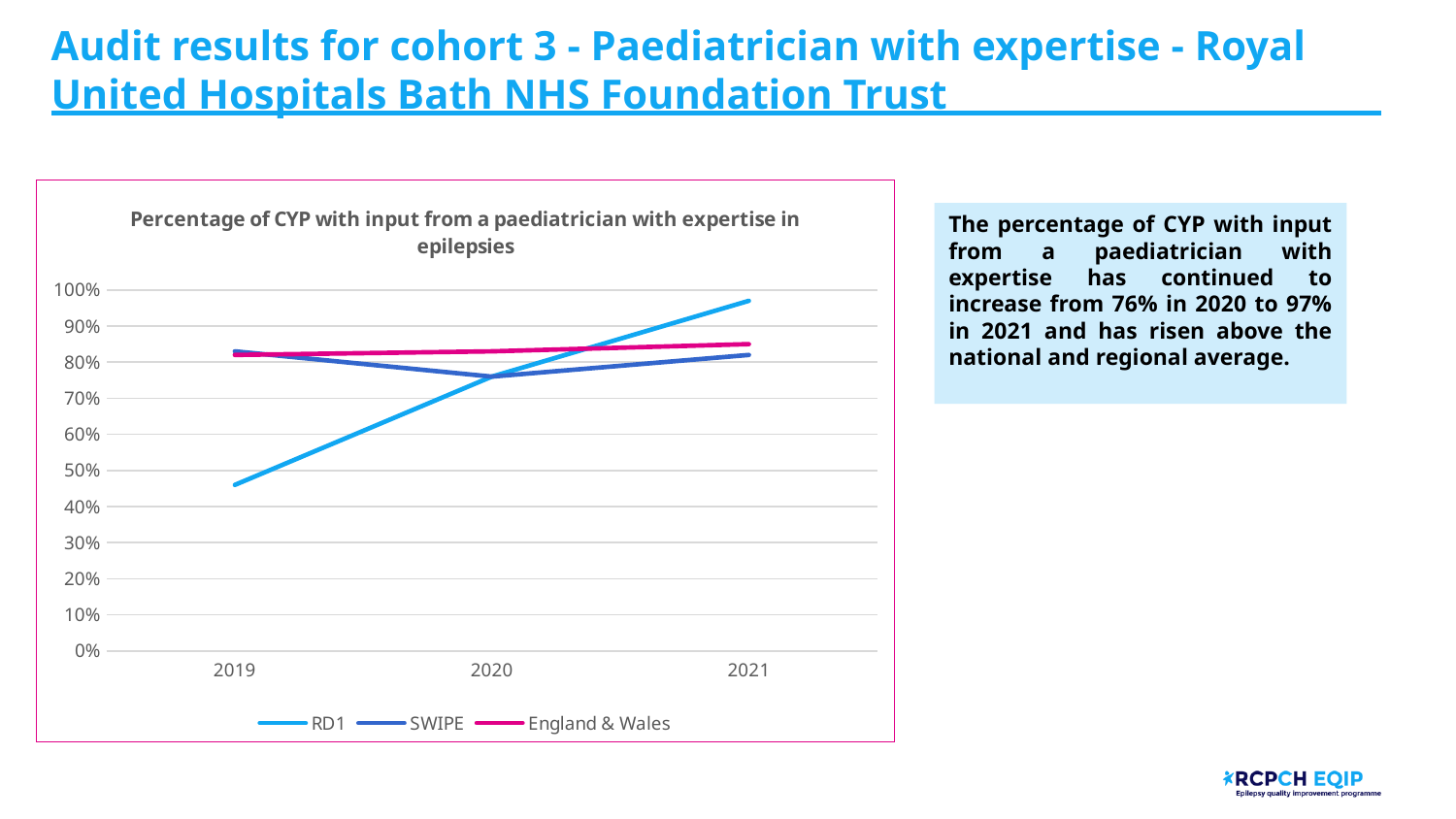
In 2019, which is larger: the value for RD1 or the value for England & Wales? England & Wales What is the title of the chart? Percentage of CYP with input from a paediatrician with expertise in epilepsies Which series has the lowest value in 2019? RD1 Is the value for SWIPE in 2020 greater or less than 70%? greater How many years are shown on the x axis of the chart? 3 Which series has the highest value in 2021? RD1 In 2021, which is larger: the value for RD1 or the value for SWIPE? RD1 Does the RD1 line rise or fall from 2019 to 2021? Rise How many series does the chart legend list? 3 What kind of chart is shown on the slide? Line chart Is the value for RD1 in 2021 greater or less than 90%? greater Is the value for RD1 in 2019 greater or less than 50%? less